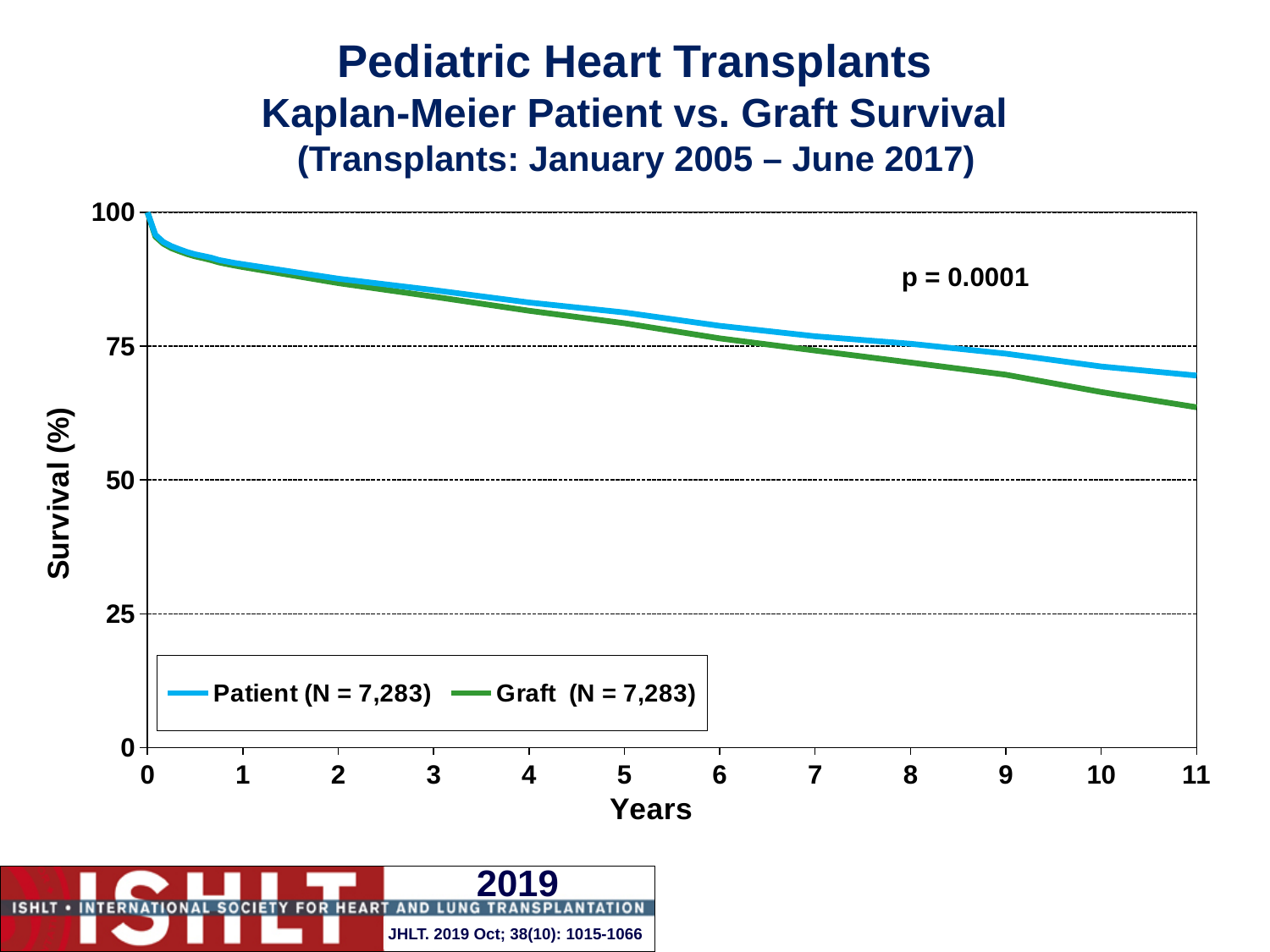
Is the Graft survival at 2 years greater or less than 75? greater What kind of chart is shown on the slide? Line chart What is the N given for the Patient series in the legend? 7,283 What is the p-value shown on the chart? p = 0.0001 At 10 years, which curve is higher: Patient or Graft? Patient Is the Graft survival at 11 years greater or less than 75? less Is the Patient survival at 5 years greater or less than 75? greater What is the highest value shown on the x axis (Years)? 11 Do the survival curves rise or fall as the years increase? Fall How many series does the legend list? 2